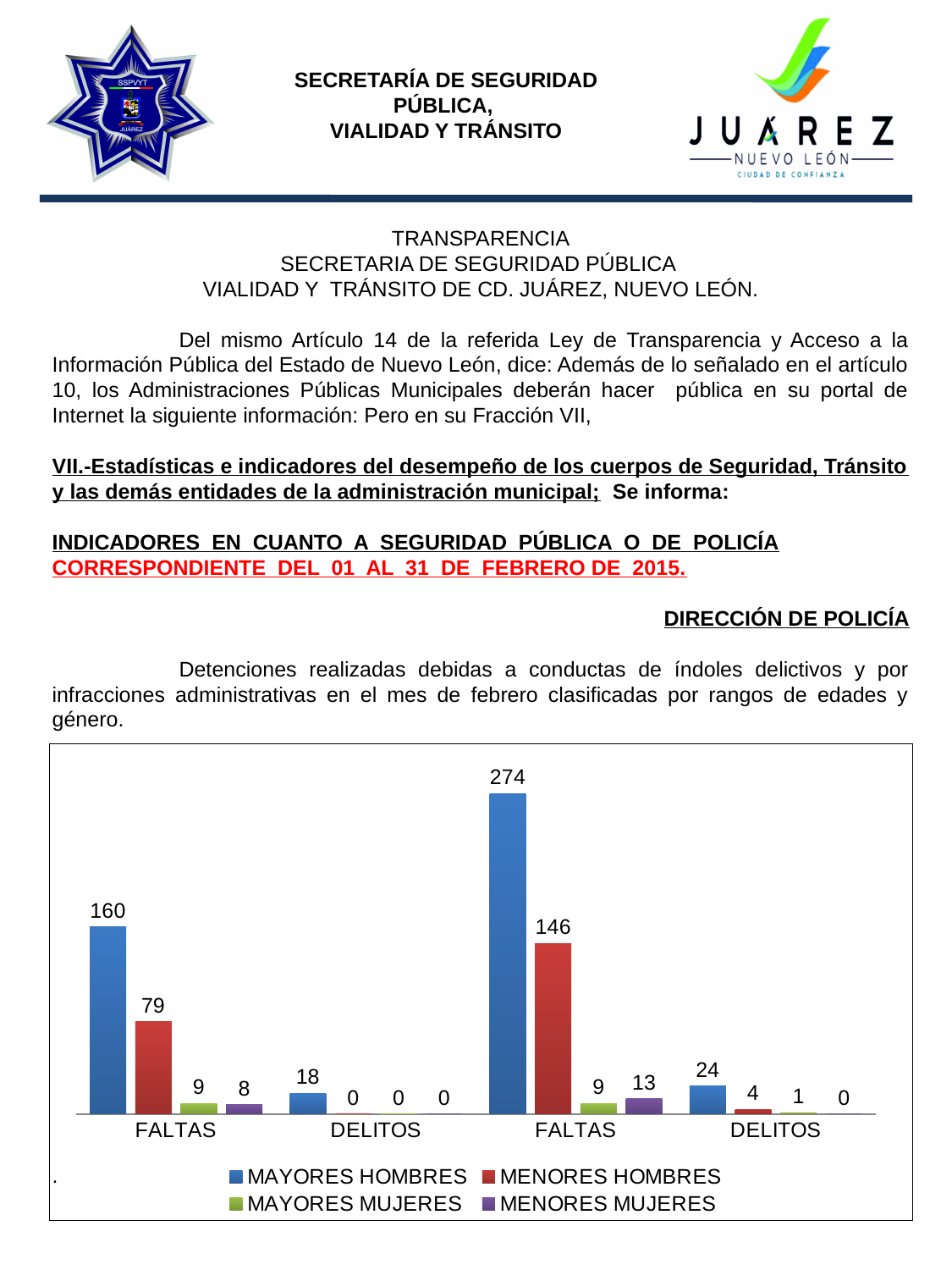
Which colour represents MENORES MUJERES in the chart? purple What is the value for MAYORES HOMBRES in the second DELITOS group (rightmost)? 24 How many series does the chart legend list? 4 How many category groups are shown along the x axis of the chart? 4 Which bar has the highest value in the whole chart? MAYORES HOMBRES in the second FALTAS group (274) What is the value for MENORES MUJERES in the second FALTAS group (third group from the left)? 13 What is the value for MENORES HOMBRES in the second FALTAS group (third group from the left)? 146 What is the value for MAYORES HOMBRES in the first FALTAS group (leftmost)? 160 What is the difference between the MAYORES HOMBRES values in the second FALTAS group (274) and the first FALTAS group (160)? 114 What kind of chart is shown on the slide? bar chart What is the difference between MAYORES HOMBRES and MENORES HOMBRES in the first FALTAS group (leftmost)? 81 In the first DELITOS group (second from the left), which is larger: MAYORES HOMBRES or MENORES HOMBRES? MAYORES HOMBRES